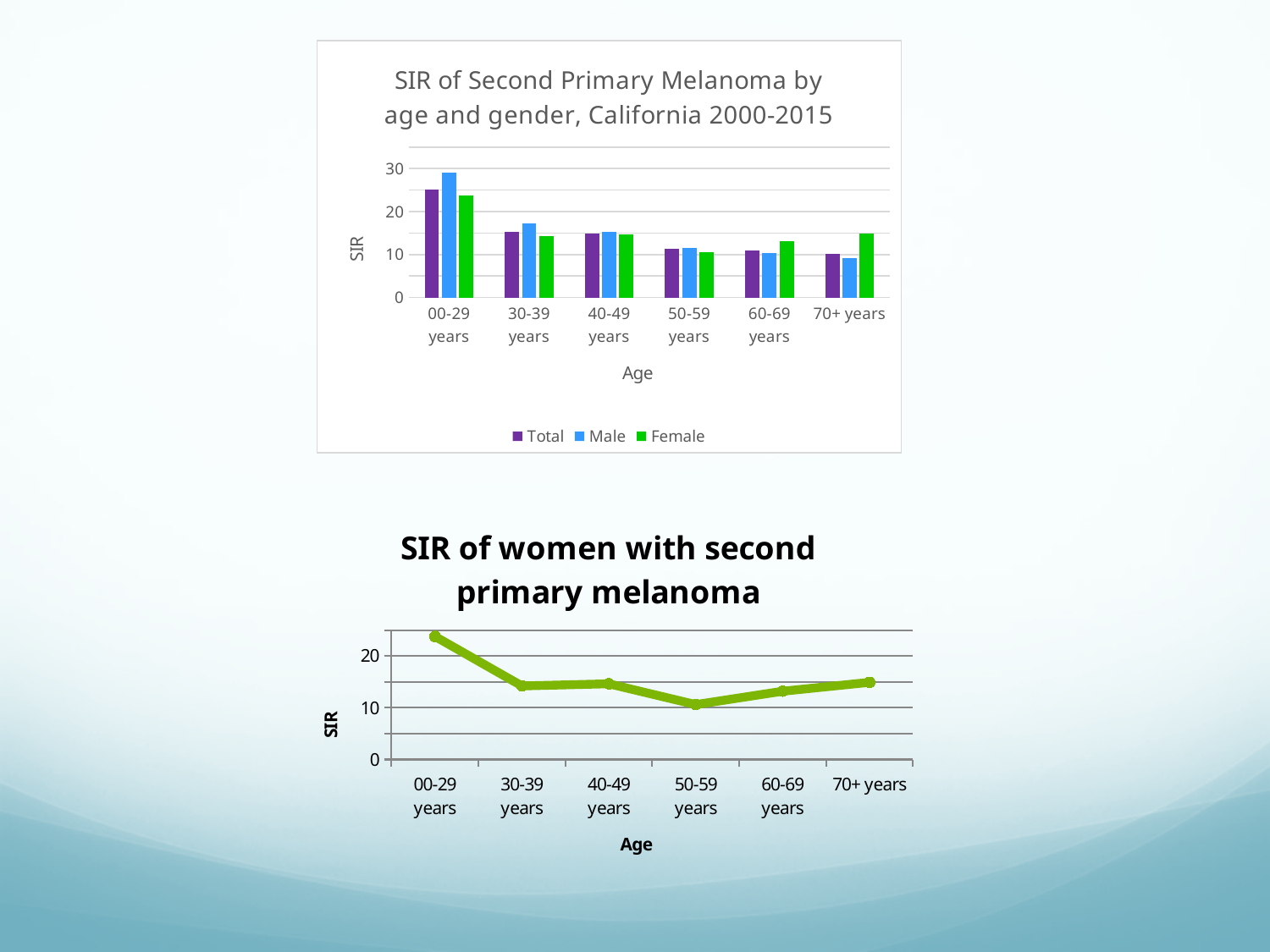
In the bottom chart, which age group has the lowest SIR? 50-59 years What kind of chart is the bottom chart, 'SIR of women with second primary melanoma'? line chart What kind of chart is the top chart, 'SIR of Second Primary Melanoma by age and gender, California 2000-2015'? bar chart In the top chart, for 00-29 years, which is larger: the Male value or the Female value? Male In the top chart, is the Male value for 00-29 years greater or less than 20? greater In the top chart, is the Total value for 70+ years greater or less than 20? less In the top chart, how many series does the legend list? 3 In the top chart, which age group has the highest Male SIR? 00-29 years In the top chart, how many age groups are shown on the x axis? 6 In the top chart, what are the three legend entries? Total, Male, Female In the bottom chart, which age group has the highest SIR? 00-29 years In the top chart, for 70+ years, which is larger: the Male value or the Female value? Female